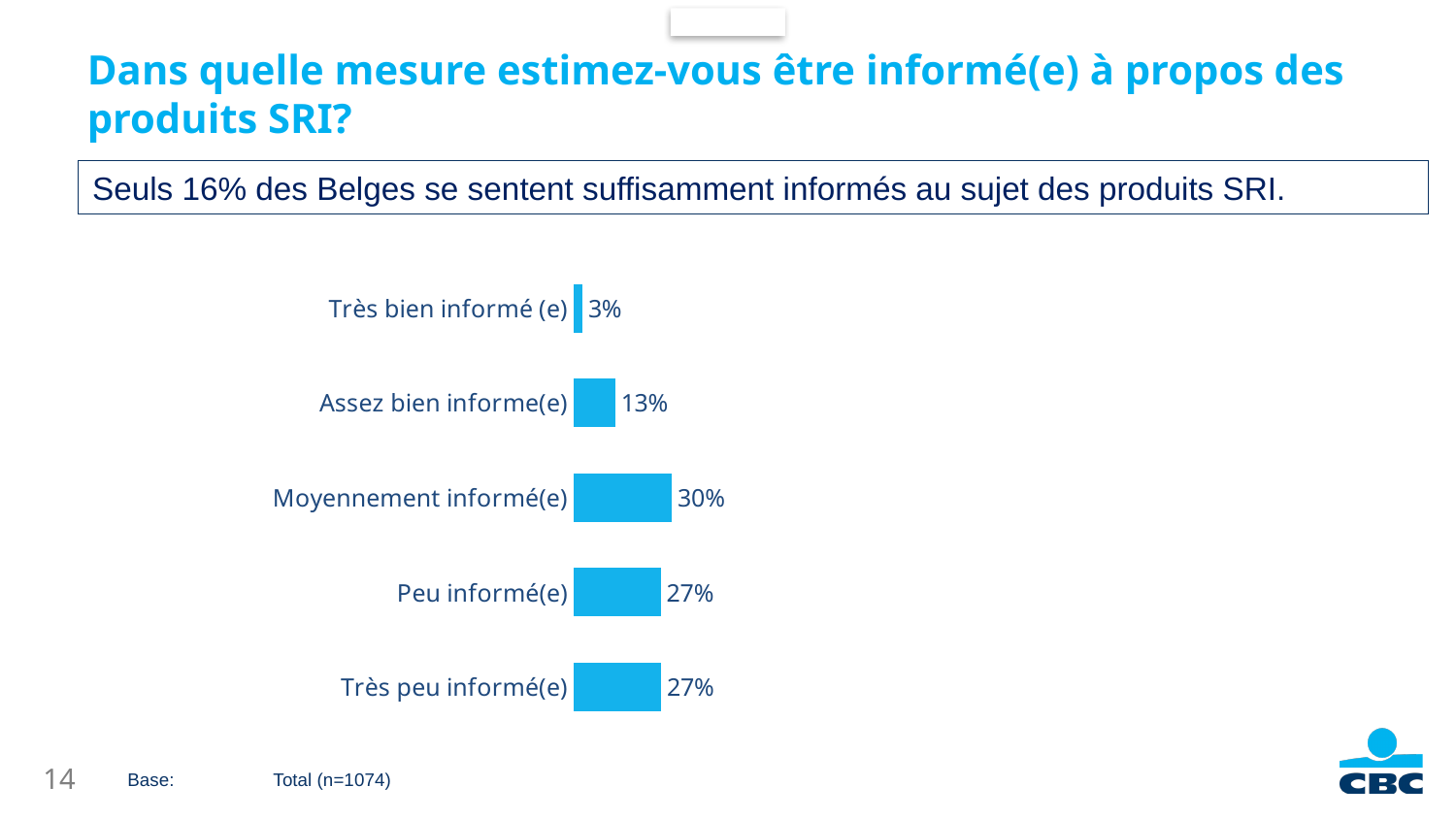
What is the value for 'Assez bien informe(e)'? 13% What kind of chart is shown on the slide? Bar chart Which is larger, the value for 'Peu informé(e)' or the value for 'Assez bien informe(e)'? Peu informé(e) Which category has the highest value? Moyennement informé(e) What is the combined value of 'Très bien informé (e)' and 'Assez bien informe(e)'? 16% What is the base (sample size) stated at the bottom of the slide? Total (n=1074) What is the difference between 'Moyennement informé(e)' and 'Assez bien informe(e)'? 17% How many categories are shown in the chart? 5 What is the value for 'Moyennement informé(e)'? 30% What is the value for 'Peu informé(e)'? 27% What percentage of respondents are 'Très bien informé (e)'? 3% Which category has the lowest value? Très bien informé (e)